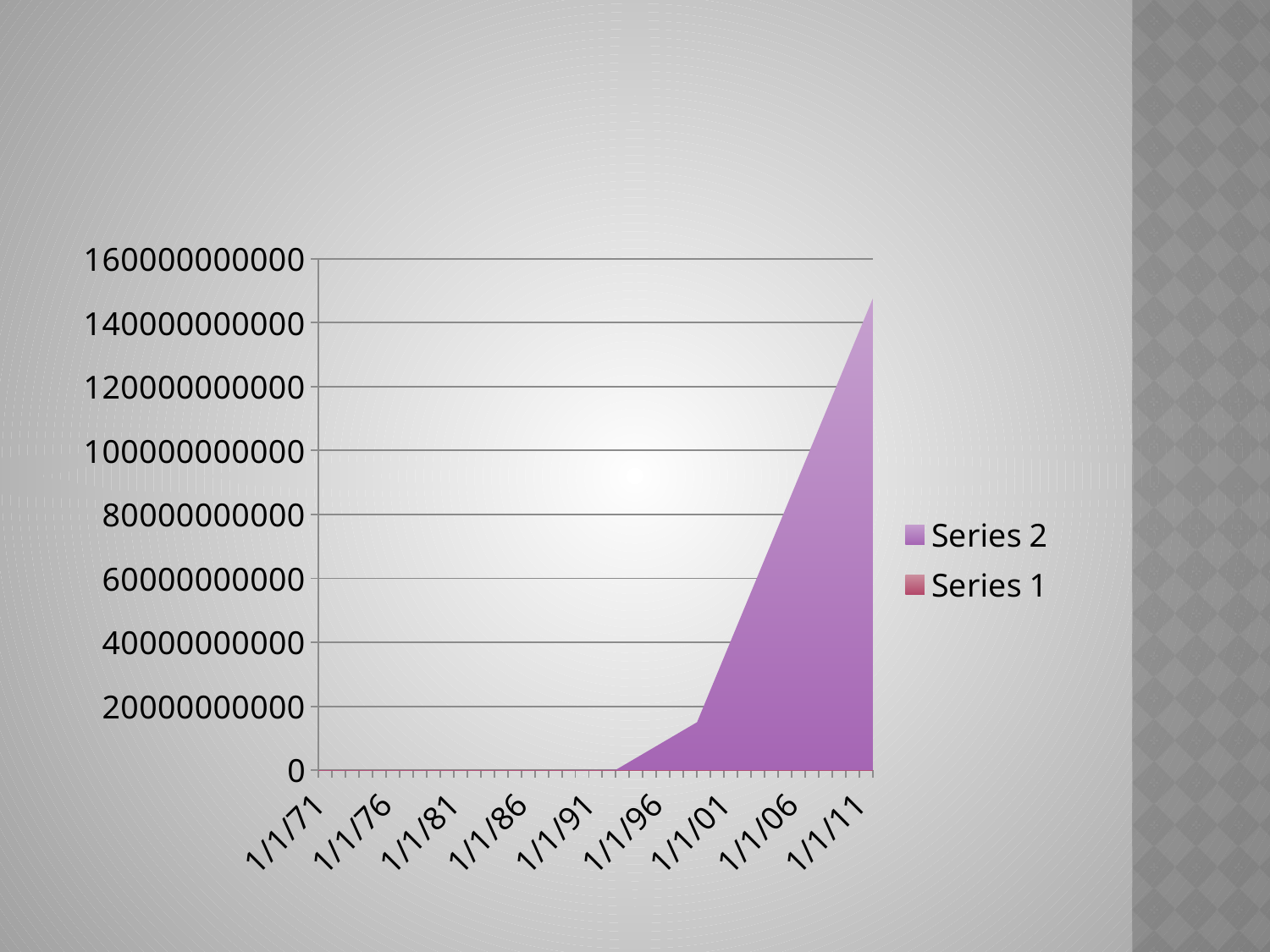
How many series does the legend list? 2 Is the value of Series 2 at 1/1/91 greater or less than 20000000000? less What kind of chart is shown on the slide? area chart Which is larger for Series 2: the value at 1/1/11 or the value at 1/1/01? 1/1/11 At which x-axis date does Series 2 reach its highest value? 1/1/11 What is the highest value shown on the y axis? 160000000000 Does the value of Series 2 rise or fall from 1/1/96 to 1/1/11? rise How many date labels are shown on the x axis? 9 What colour is Series 2 in the chart? purple What are the names of the series in the legend? Series 2 and Series 1